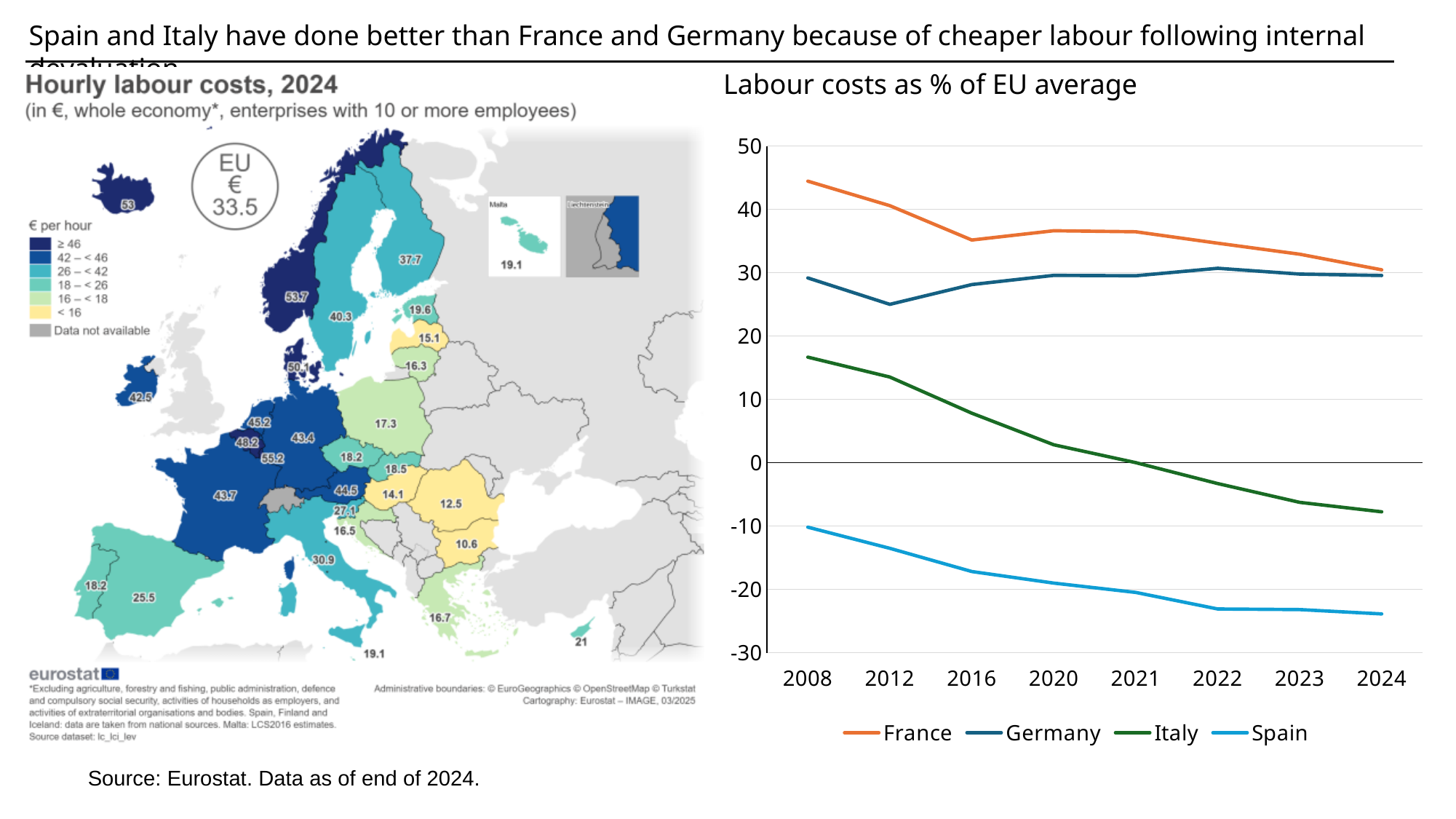
In the 'Labour costs as % of EU average' chart, which colour is the Italy line? green In the 'Labour costs as % of EU average' chart, does the France line rise or fall from 2008 to 2024? fall How many years are shown on the x axis of the 'Labour costs as % of EU average' chart? 8 In the 'Labour costs as % of EU average' chart, is the value for Spain in 2024 greater or less than -20? less In the 'Labour costs as % of EU average' chart, which country has the lowest value in 2008? Spain What kind of chart is 'Labour costs as % of EU average'? line chart In the 'Labour costs as % of EU average' chart, does the Spain line rise or fall from 2008 to 2024? fall In the 'Labour costs as % of EU average' chart, is the value for France in 2008 greater or less than 40? greater In the 'Labour costs as % of EU average' chart, is the value for Germany in 2012 greater or less than 30? less In the 'Labour costs as % of EU average' chart, does the Italy line rise or fall from 2008 to 2024? fall How many series does the legend of the 'Labour costs as % of EU average' chart list? 4